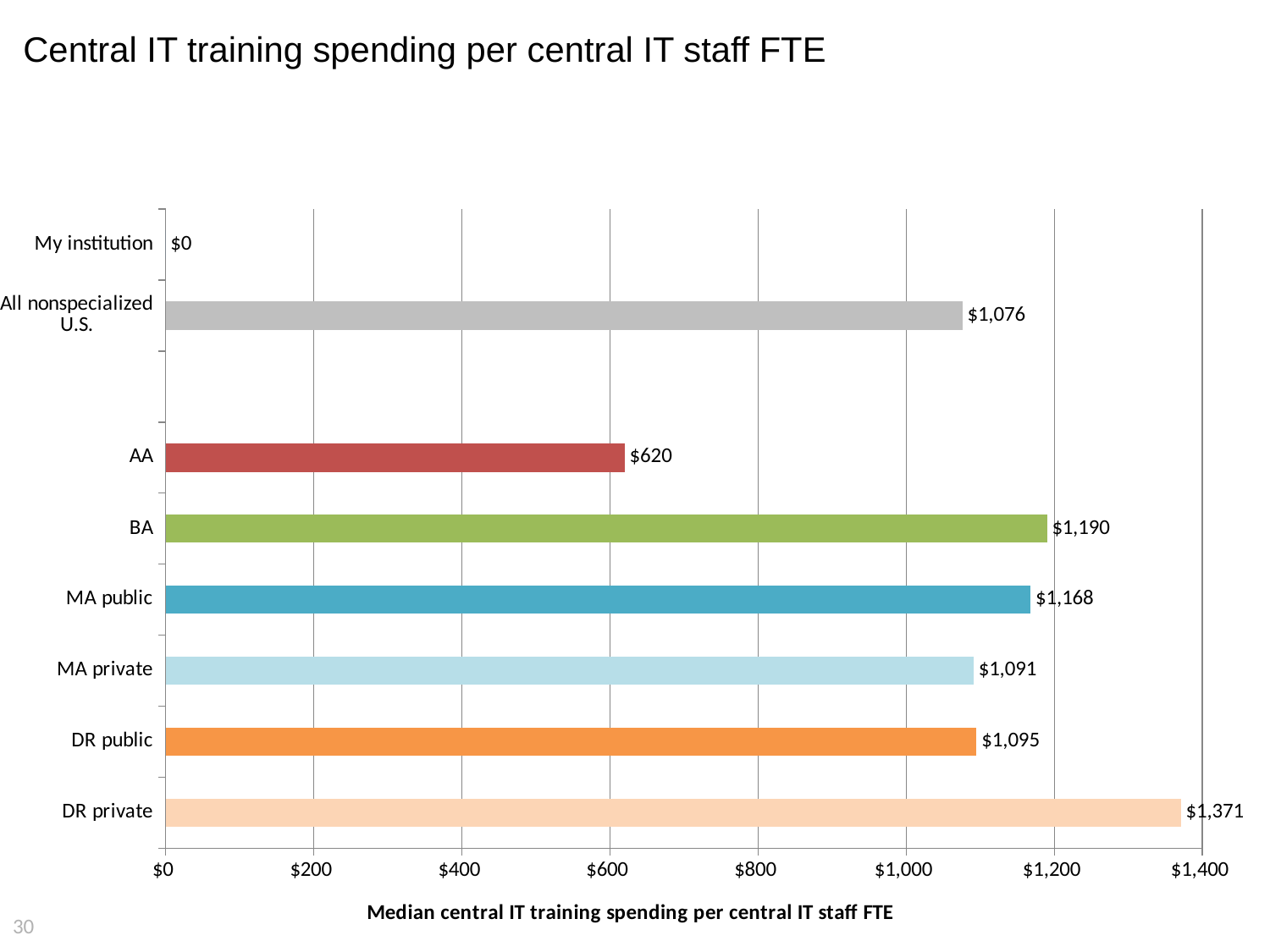
Among the Carnegie class categories (AA, BA, MA public, MA private, DR public, DR private), which has the lowest value? AA Which category has the highest value? DR private What is the value for DR private? $1,371 Is the value for MA private greater or less than $1,000? greater What is the value for My institution? $0 What is the difference between the values for BA and AA? $570 Which is larger, the value for BA or the value for MA public? BA What is the difference between the values for DR private and DR public? $276 What is the value for All nonspecialized U.S.? $1,076 What kind of chart is shown on the slide? bar chart What is the x-axis title of the chart? Median central IT training spending per central IT staff FTE What is the value for AA? $620